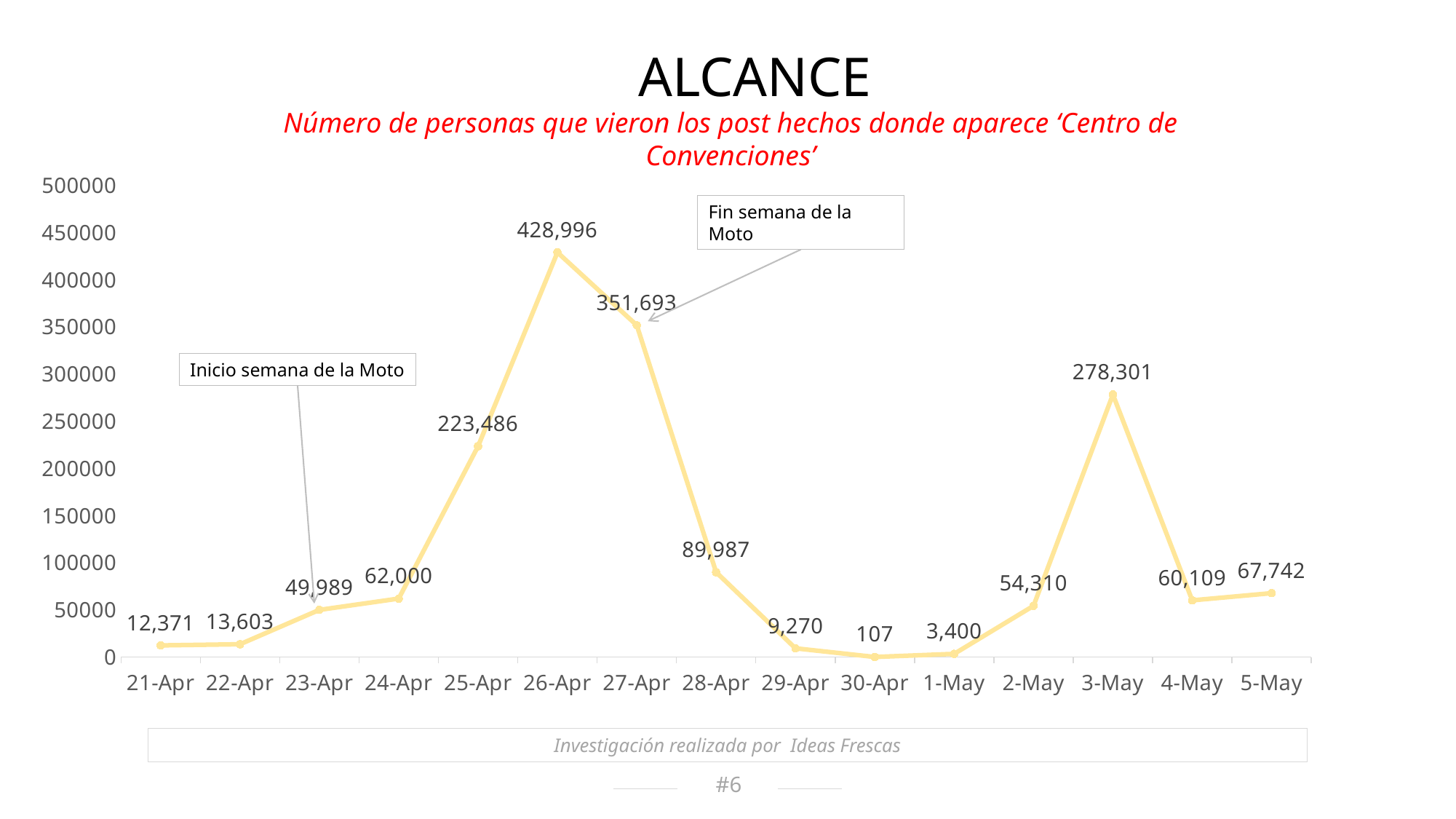
Which date has the highest value? 26-Apr Which date has the lowest value? 30-Apr What is the value for 26-Apr? 428,996 What is the value for 3-May? 278,301 What is the value for 21-Apr? 12,371 What is the difference between the values for 26-Apr and 27-Apr? 77,303 Is the value for 28-Apr greater or less than 100000? less Which is larger, the value for 25-Apr or the value for 3-May? 3-May How many dates are plotted on the x axis? 15 Do the values rise or fall from 26-Apr to 30-Apr? fall What is the value for 30-Apr? 107 What kind of chart is shown on the slide? line chart